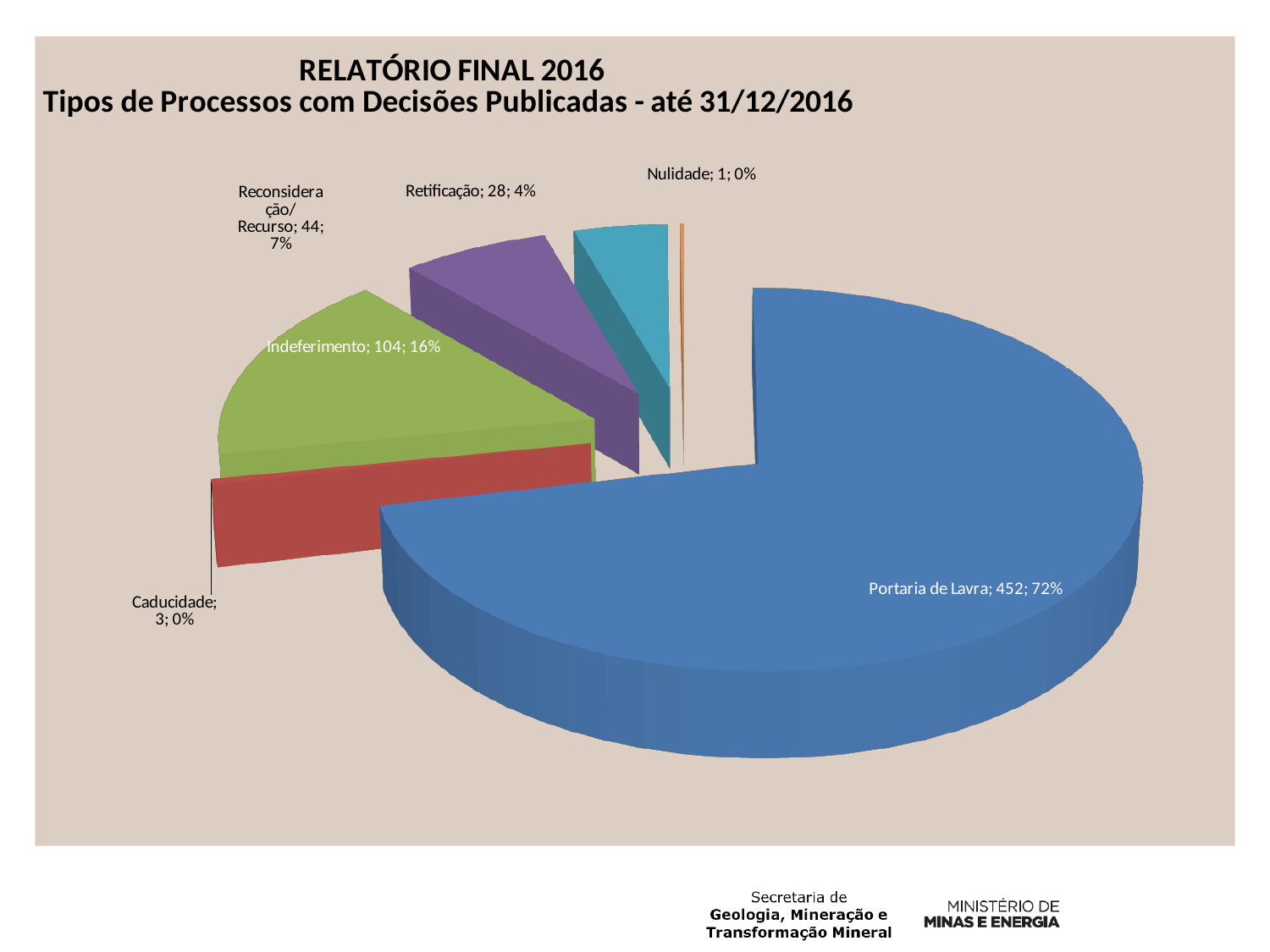
Which category has the lowest value? Nulidade What kind of chart is shown on the slide? Pie chart How many categories (slices) does the pie chart show? 6 Which is larger, the value for Retificação or the value for Caducidade? Retificação What is the value for Retificação? 28 What is the value for Indeferimento? 104 What is the value for Reconsideração/Recurso? 44 Which category has the highest value? Portaria de Lavra What is the difference between the values for Indeferimento and Reconsideração/Recurso? 60 What is the value for Portaria de Lavra? 452 What share of the pie does Portaria de Lavra represent? 72% What share of the pie does Indeferimento represent? 16%